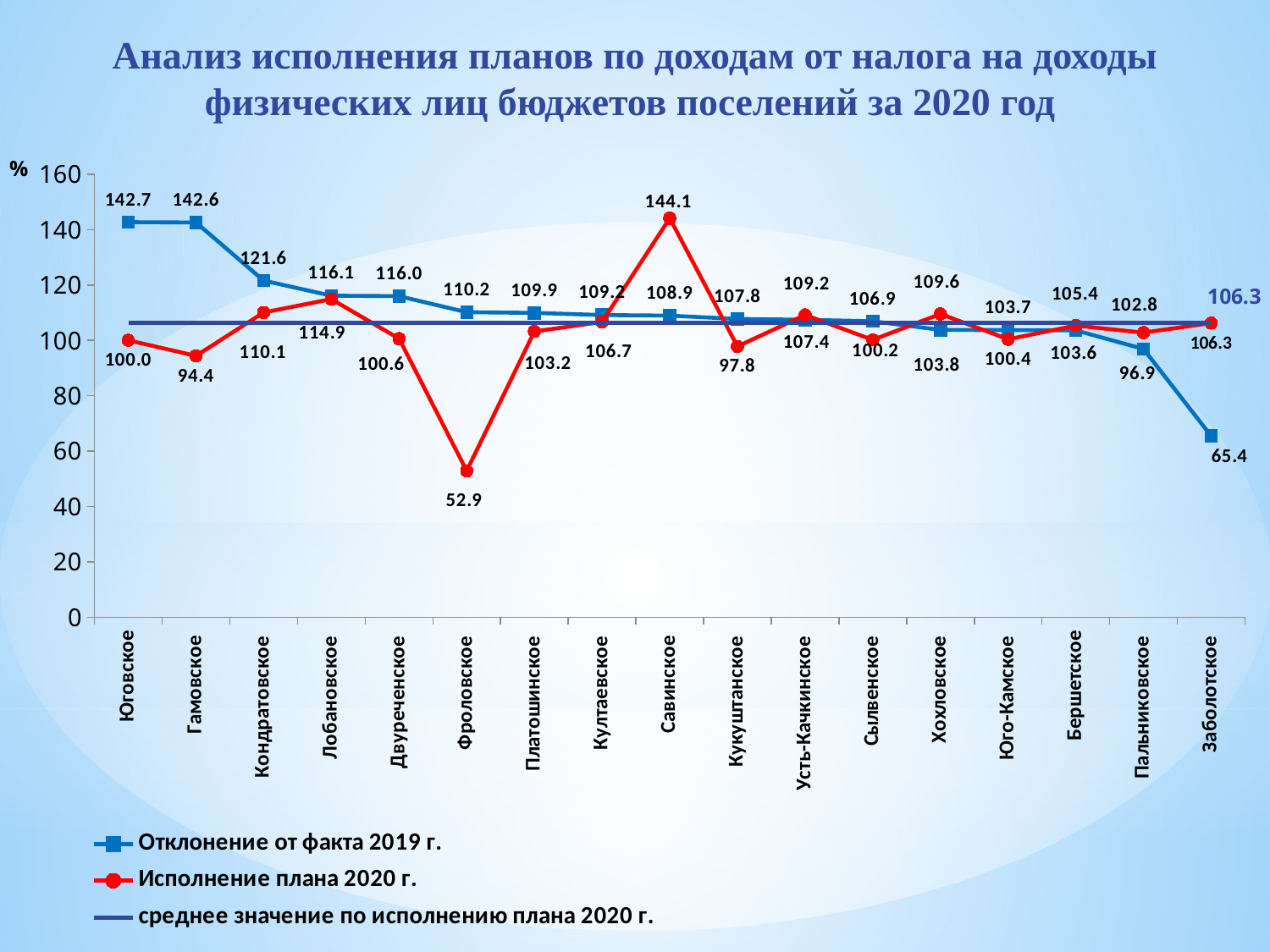
For Савинское, which is larger: "Отклонение от факта 2019 г." or "Исполнение плана 2020 г."? Исполнение плана 2020 г. Which settlement has the highest value for "Исполнение плана 2020 г."? Савинское What is the value of "Отклонение от факта 2019 г." for Заболотское? 65.4 What is the value of "Исполнение плана 2020 г." for Фроловское? 52.9 Which settlement has the lowest value for "Исполнение плана 2020 г."? Фроловское What is the difference between "Отклонение от факта 2019 г." and "Исполнение плана 2020 г." for Юговское? 42.7 What kind of chart is shown on the slide? line chart How many settlements are plotted along the x axis? 17 What is the value of the line "среднее значение по исполнению плана 2020 г."? 106.3 How many series does the legend list? 3 Which settlement has the lowest value for "Отклонение от факта 2019 г."? Заболотское What is the value of "Исполнение плана 2020 г." for Савинское? 144.1